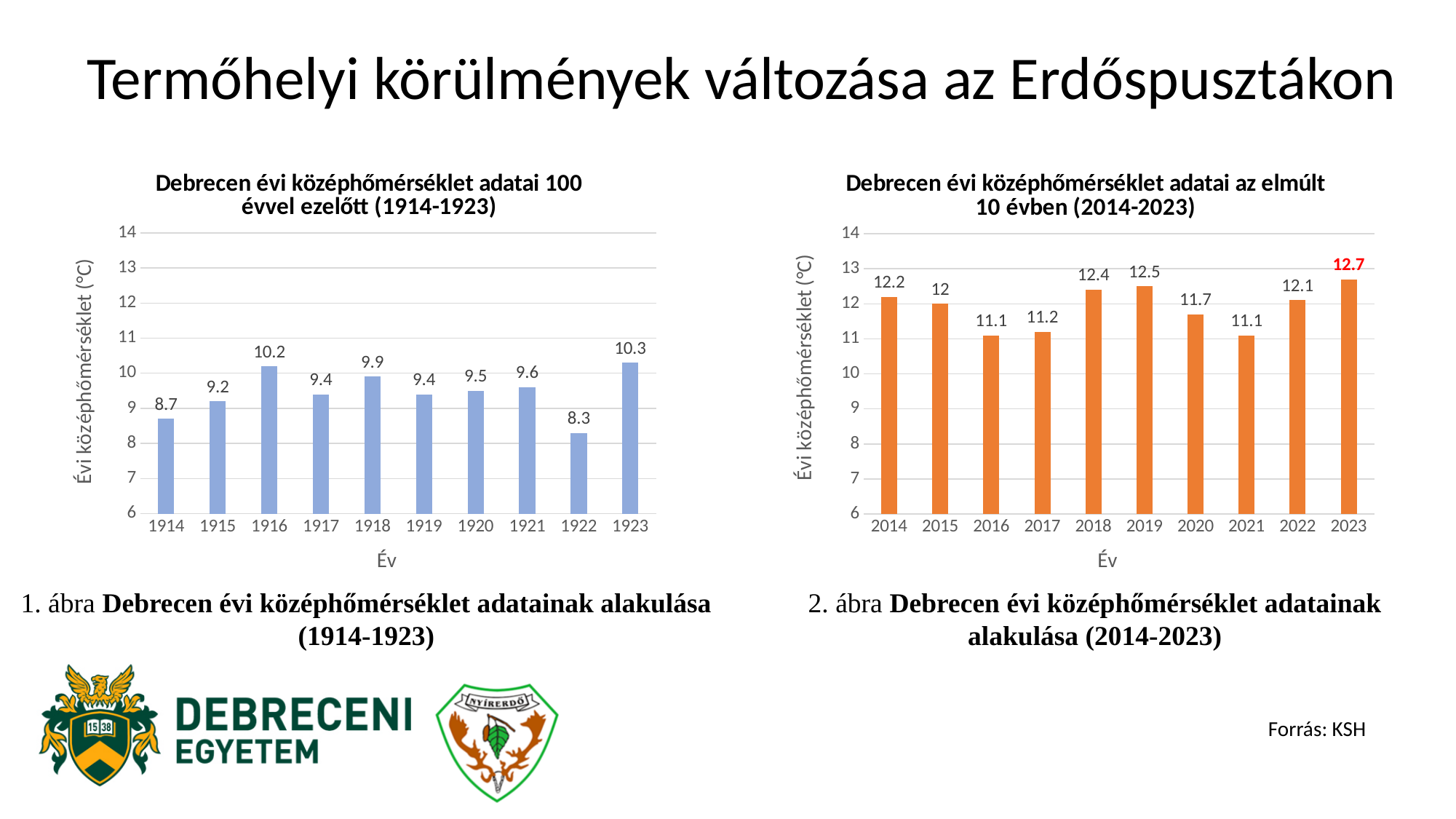
What type of chart is the right chart (2014-2023)? bar chart In the left chart (1914-1923), which year has the highest annual mean temperature? 1923 What is the y-axis label of the left chart (1914-1923)? Évi középhőmérséklet (°C) In the left chart (1914-1923), which year has the lowest annual mean temperature? 1922 In the right chart (2014-2023), what is the difference between the values for 2023 and 2016? 1.6 In the left chart (1914-1923), how many years are plotted? 10 In the right chart (2014-2023), is the value for 2021 greater or less than 12? less In the left chart (1914-1923), what is the difference between the values for 1923 and 1922? 2 In the left chart (1914-1923), what is the annual mean temperature for 1916? 10.2 In the right chart (2014-2023), which year has the highest annual mean temperature? 2023 In the right chart (2014-2023), what is the annual mean temperature for 2019? 12.5 In the right chart (2014-2023), which is larger, the value for 2018 or the value for 2020? 2018